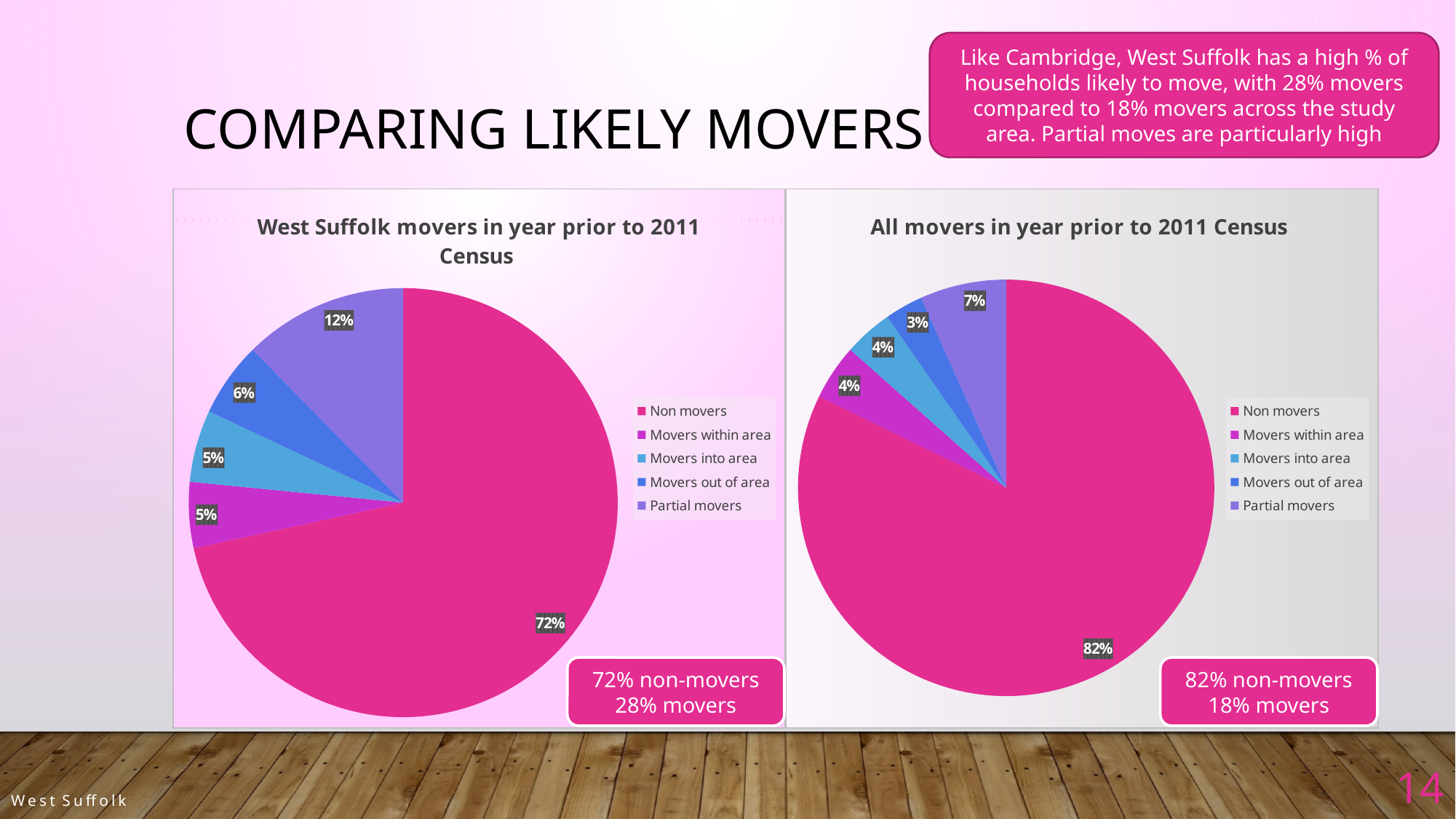
What type of chart is the 'All movers in year prior to 2011 Census' chart? Pie chart In the 'West Suffolk movers in year prior to 2011 Census' chart, what share of the pie is Non movers? 72% How many categories does the legend of the 'West Suffolk movers in year prior to 2011 Census' chart list? 5 In the 'West Suffolk movers in year prior to 2011 Census' chart, which category has the largest slice? Non movers In the 'All movers in year prior to 2011 Census' chart, which category has the smallest slice? Movers out of area In the 'West Suffolk movers in year prior to 2011 Census' chart, what percentage is shown for Movers out of area? 6% Which is larger: Partial movers in the 'West Suffolk movers in year prior to 2011 Census' chart or Partial movers in the 'All movers in year prior to 2011 Census' chart? West Suffolk movers in year prior to 2011 Census In the 'All movers in year prior to 2011 Census' chart, what percentage is shown for Movers out of area? 3% In the 'All movers in year prior to 2011 Census' chart, what share of the pie is Non movers? 82% What is the difference between the Non movers share in the 'All movers in year prior to 2011 Census' chart and the Non movers share in the 'West Suffolk movers in year prior to 2011 Census' chart? 10% In the 'All movers in year prior to 2011 Census' chart, what percentage is shown for Partial movers? 7% In the 'West Suffolk movers in year prior to 2011 Census' chart, what percentage is shown for Partial movers? 12%